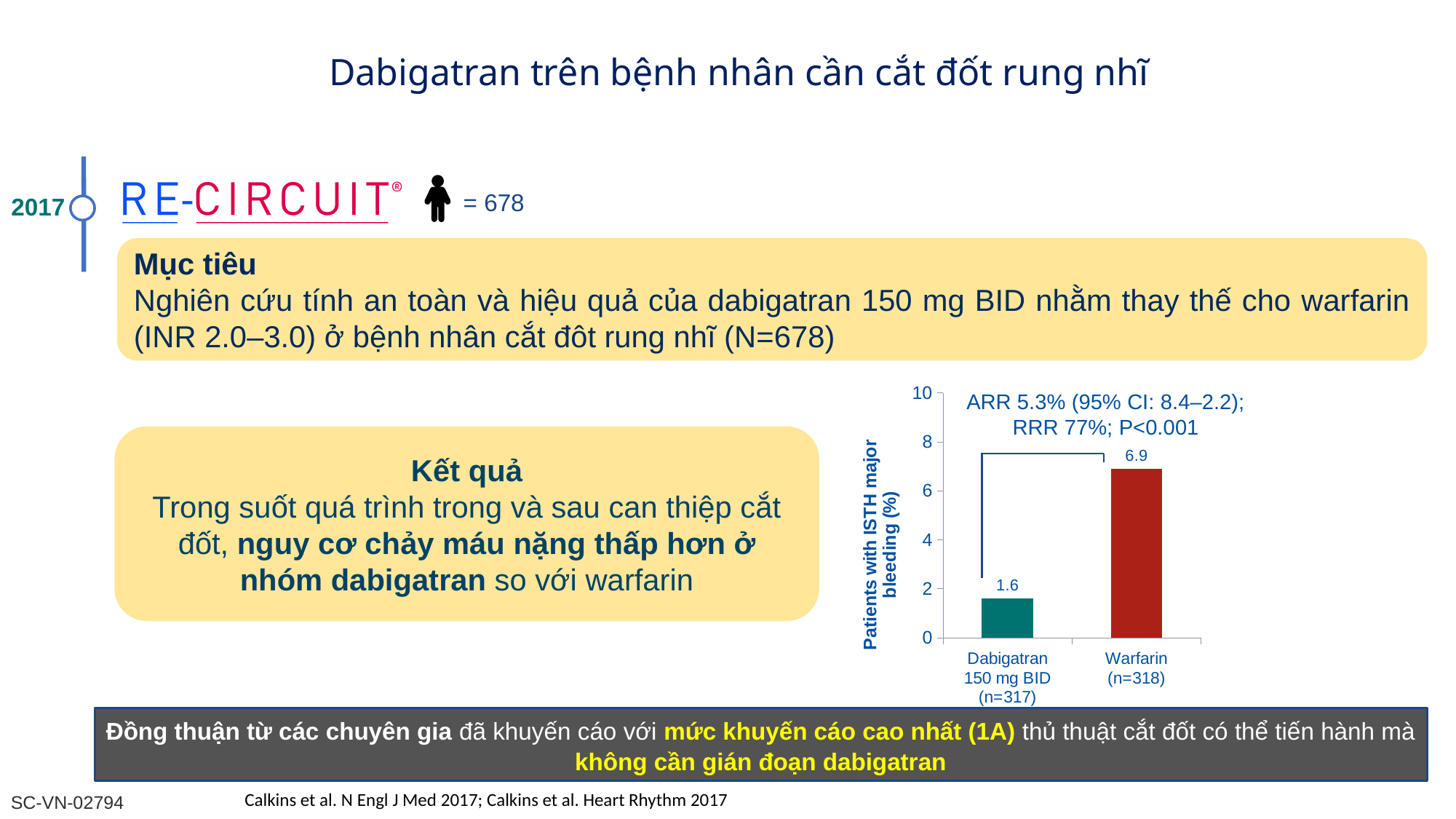
What is the value for Warfarin in the bar chart? 6.9 Is the value for Dabigatran 150 mg BID greater or less than 2? less Which group has the higher rate of ISTH major bleeding? Warfarin How many bars are shown in the chart? 2 Which group has the lower rate of ISTH major bleeding? Dabigatran 150 mg BID What kind of chart is shown on the slide? Bar chart Is the value for Warfarin greater or less than 6? greater What is the maximum value shown on the y axis of the chart? 10 What is the label of the y axis of the chart? Patients with ISTH major bleeding (%) What is the value for Dabigatran 150 mg BID in the bar chart? 1.6 What is the difference between the Warfarin and Dabigatran 150 mg BID values? 5.3 What is the number of patients (n) in the Warfarin group shown in the chart? 318